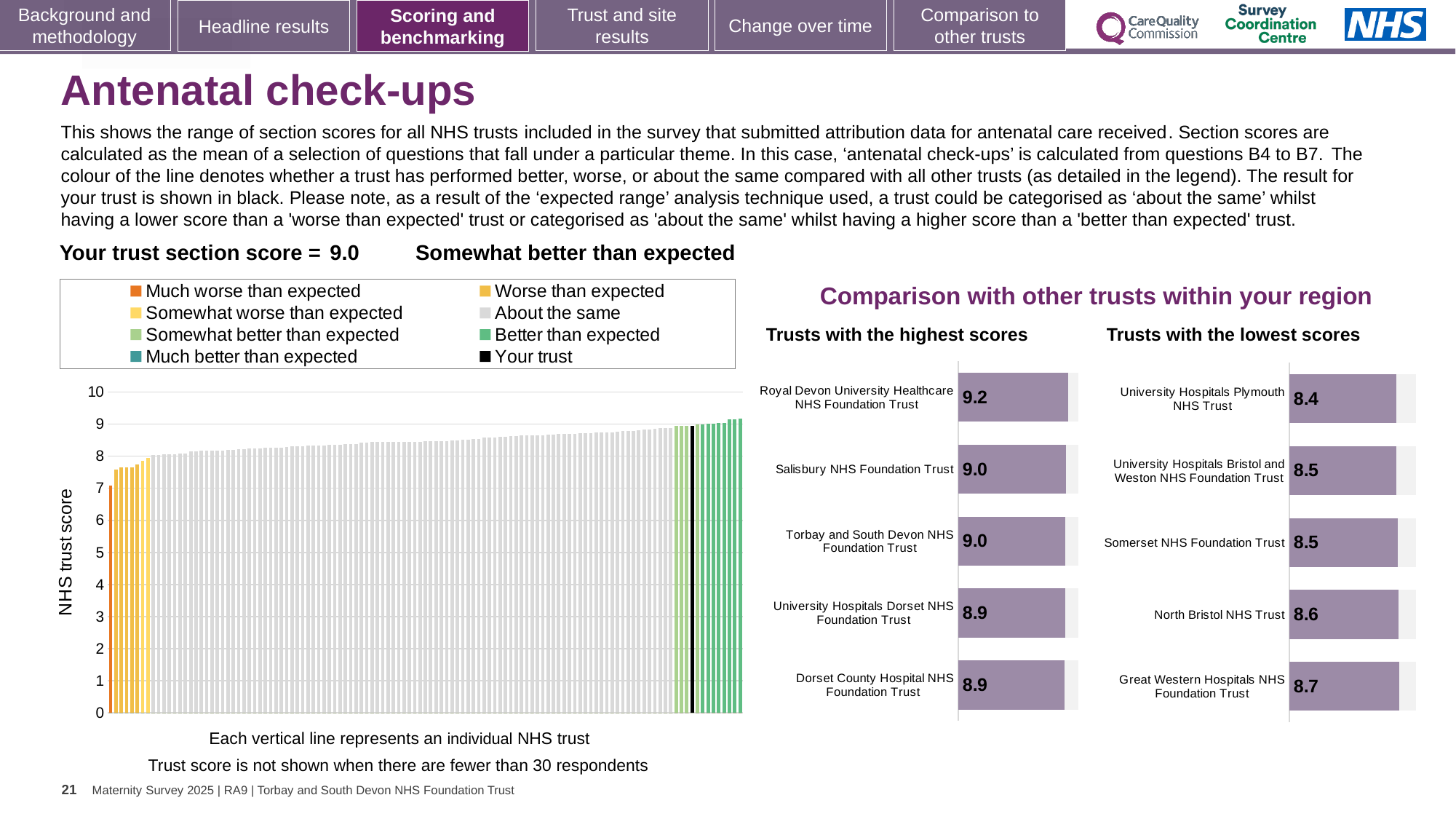
In the 'Trusts with the highest scores' chart, which trust has the highest score? Royal Devon University Healthcare NHS Foundation Trust In the main 'NHS trust score' chart, is the value of the leftmost (orange) bar greater or less than 8? less How many entries does the legend above the main 'NHS trust score' chart list? 8 In the 'Trusts with the lowest scores' chart, which trust has the lowest score? University Hospitals Plymouth NHS Trust How many trusts are shown in the 'Trusts with the highest scores' chart? 5 What kind of chart is the main chart on the left with the 'NHS trust score' axis? bar chart In the 'Trusts with the lowest scores' chart, what is the difference between the scores of Great Western Hospitals NHS Foundation Trust and University Hospitals Plymouth NHS Trust? 0.3 In the 'Trusts with the lowest scores' chart, which has the higher score: North Bristol NHS Trust or Somerset NHS Foundation Trust? North Bristol NHS Trust In the main 'NHS trust score' chart, do the values rise or fall from left to right? rise In the 'Trusts with the highest scores' chart, what is the score for Royal Devon University Healthcare NHS Foundation Trust? 9.2 In the 'Trusts with the highest scores' chart, what is the difference between the scores of Royal Devon University Healthcare NHS Foundation Trust and Dorset County Hospital NHS Foundation Trust? 0.3 In the 'Trusts with the lowest scores' chart, what is the score for University Hospitals Plymouth NHS Trust? 8.4